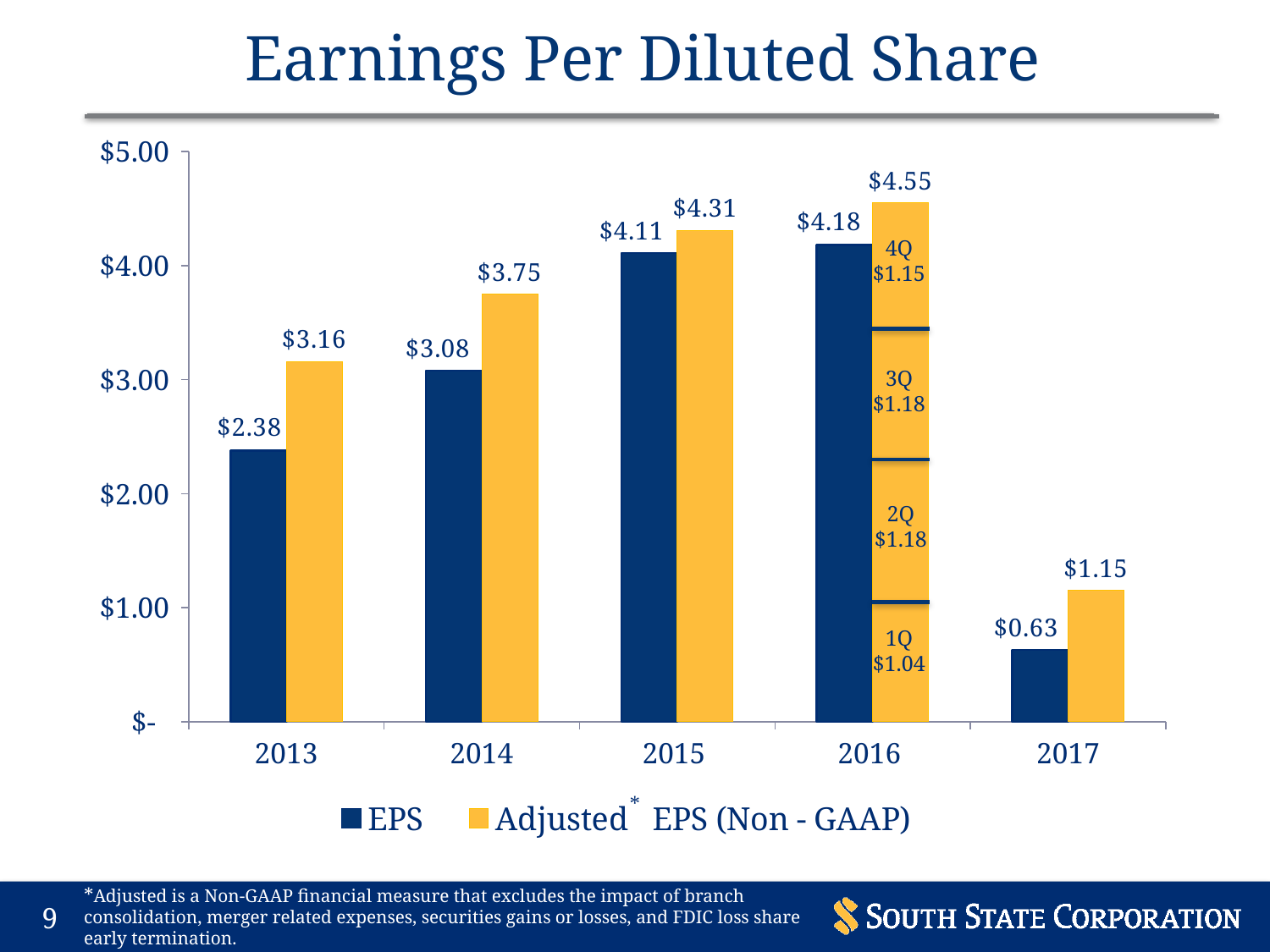
What is the difference between Adjusted EPS and EPS in 2013? $0.78 What kind of chart is shown on the slide? Bar chart What is the title of the chart? Earnings Per Diluted Share Which is larger, the EPS for 2015 or the EPS for 2016? EPS for 2016 Which year has the highest Adjusted EPS (Non-GAAP) value? 2016 How many years are shown on the x axis? 5 Is the Adjusted EPS value for 2014 greater or less than $3.00? greater What is the 3Q Adjusted EPS value shown within the 2016 bar? $1.18 How many series does the legend list? 2 What is the Adjusted EPS (Non-GAAP) value for 2015? $4.31 What is the EPS value for 2014? $3.08 Which year has the lowest EPS value? 2017